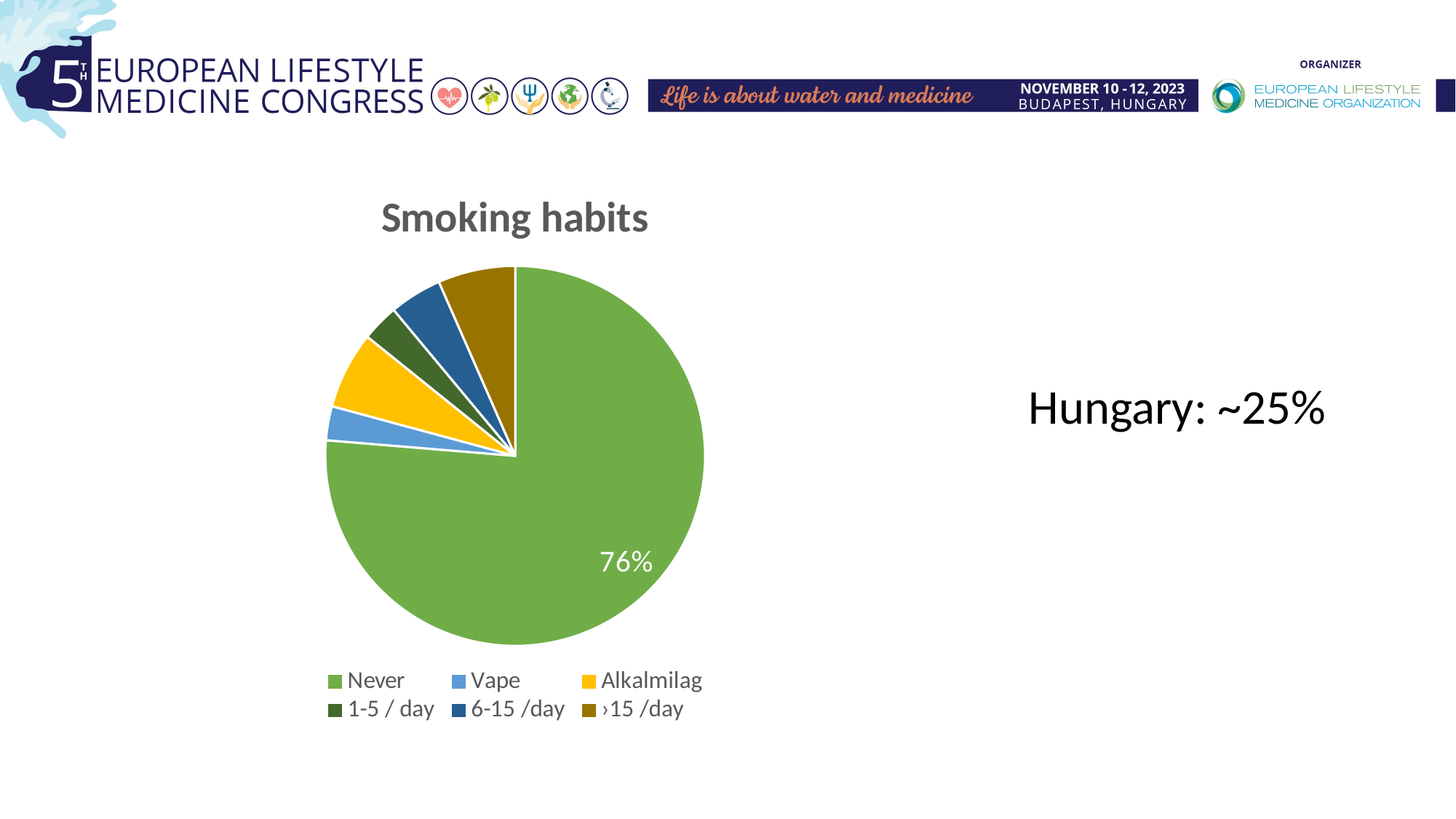
Which category has the largest slice of the pie? Never What colour is the Never slice in the pie chart? green What kind of chart is shown on the slide? pie chart Which slice is larger, Never or Vape? Never What share of the pie does the Never category take? 76% What percentage is shown for the Never slice? 76% How many categories does the pie chart have? 6 Which slice is larger, Alkalmilag or 6-15 /day? Alkalmilag What is the title of the chart? Smoking habits Which slice is larger, Alkalmilag or Vape? Alkalmilag